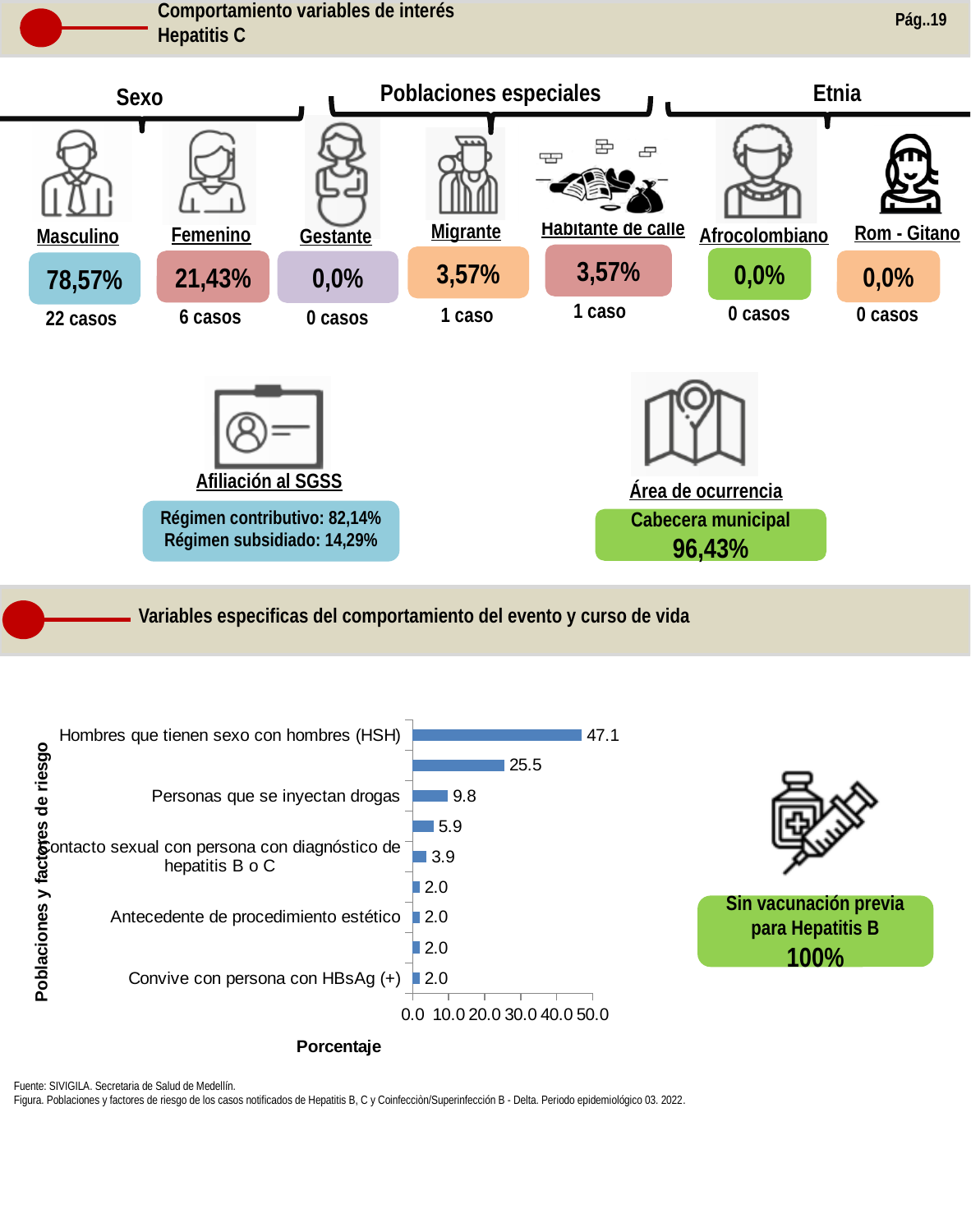
What is the value for 'Personas que se inyectan drogas' in the bar chart? 9.8 What is the difference between the values for 'Hombres que tienen sexo con hombres (HSH)' and 'Personas que se inyectan drogas' in the bar chart? 37.3 Which is larger in the bar chart: the value for 'Personas que se inyectan drogas' or for 'Contacto sexual con persona con diagnóstico de hepatitis B o C'? Personas que se inyectan drogas What is the title of the horizontal axis of the bar chart? Porcentaje What is the value for 'Convive con persona con HBsAg (+)' in the bar chart? 2.0 What is the value for 'Antecedente de procedimiento estético' in the bar chart? 2.0 What is the value for 'Hombres que tienen sexo con hombres (HSH)' in the bar chart? 47.1 What kind of chart is shown at the bottom of the slide? Bar chart Which category has the highest value in the bar chart? Hombres que tienen sexo con hombres (HSH) What is the difference between the values for 'Contacto sexual con persona con diagnóstico de hepatitis B o C' and 'Antecedente de procedimiento estético' in the bar chart? 1.9 How many bars are plotted in the bar chart? 9 What is the value for 'Contacto sexual con persona con diagnóstico de hepatitis B o C' in the bar chart? 3.9